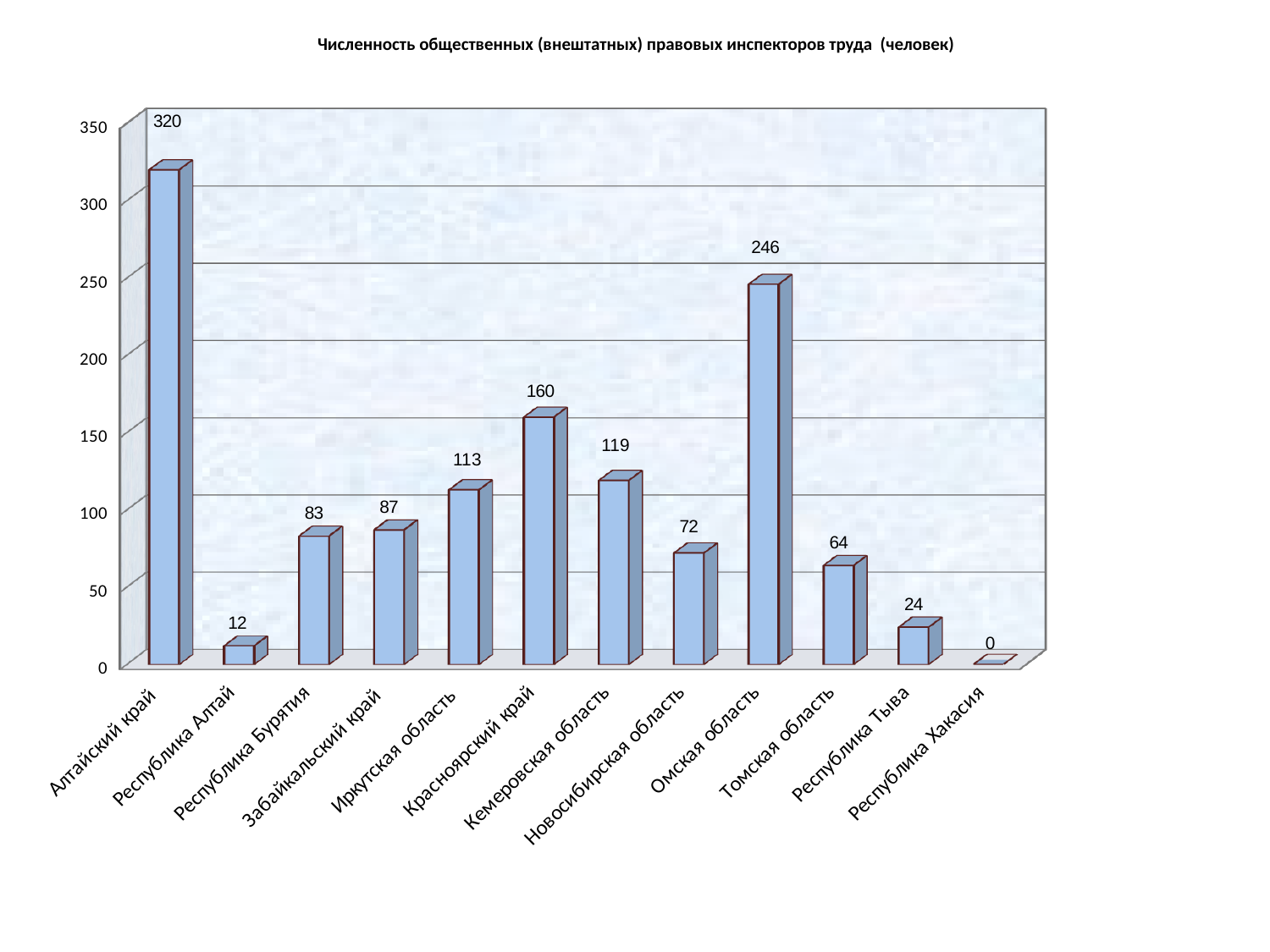
What is the difference between the values for Забайкальский край and Республика Бурятия? 4 Is the value for Иркутская область greater or less than 100? greater What is the value for Республика Тыва? 24 How many categories are shown on the x axis? 12 What is the value for Омская область? 246 Which category has the lowest value? Республика Хакасия What is the value for Алтайский край? 320 Which category has the highest value? Алтайский край What kind of chart is this? bar chart What is the title of the chart? Численность общественных (внештатных) правовых инспекторов труда (человек) What is the difference between the values for Алтайский край and Омская область? 74 Which is larger, the value for Красноярский край or the value for Кемеровская область? Красноярский край